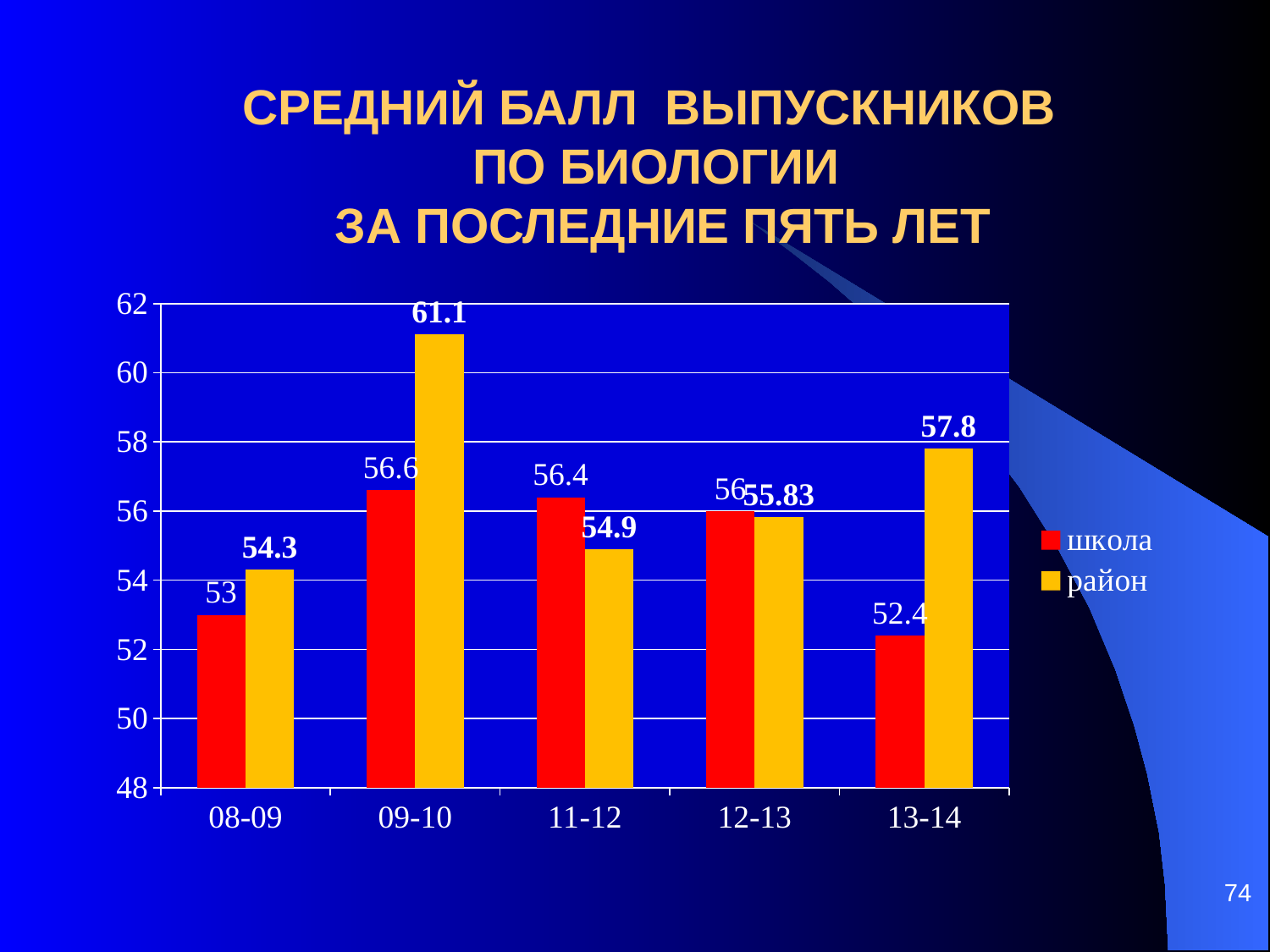
What kind of chart is shown on the slide? bar chart What is the value for школа in 09-10? 56.6 How many series does the legend list? 2 What is the value for район in 13-14? 57.8 What is the difference between район and школа in 09-10? 4.5 Which colour represents район in the legend? yellow What is the value for школа in 13-14? 52.4 In which year is the район value highest? 09-10 What is the value for район in 12-13? 55.83 Which is larger in 11-12, школа or район? школа How many year categories are shown on the x axis? 5 In which year is the школа value lowest? 13-14